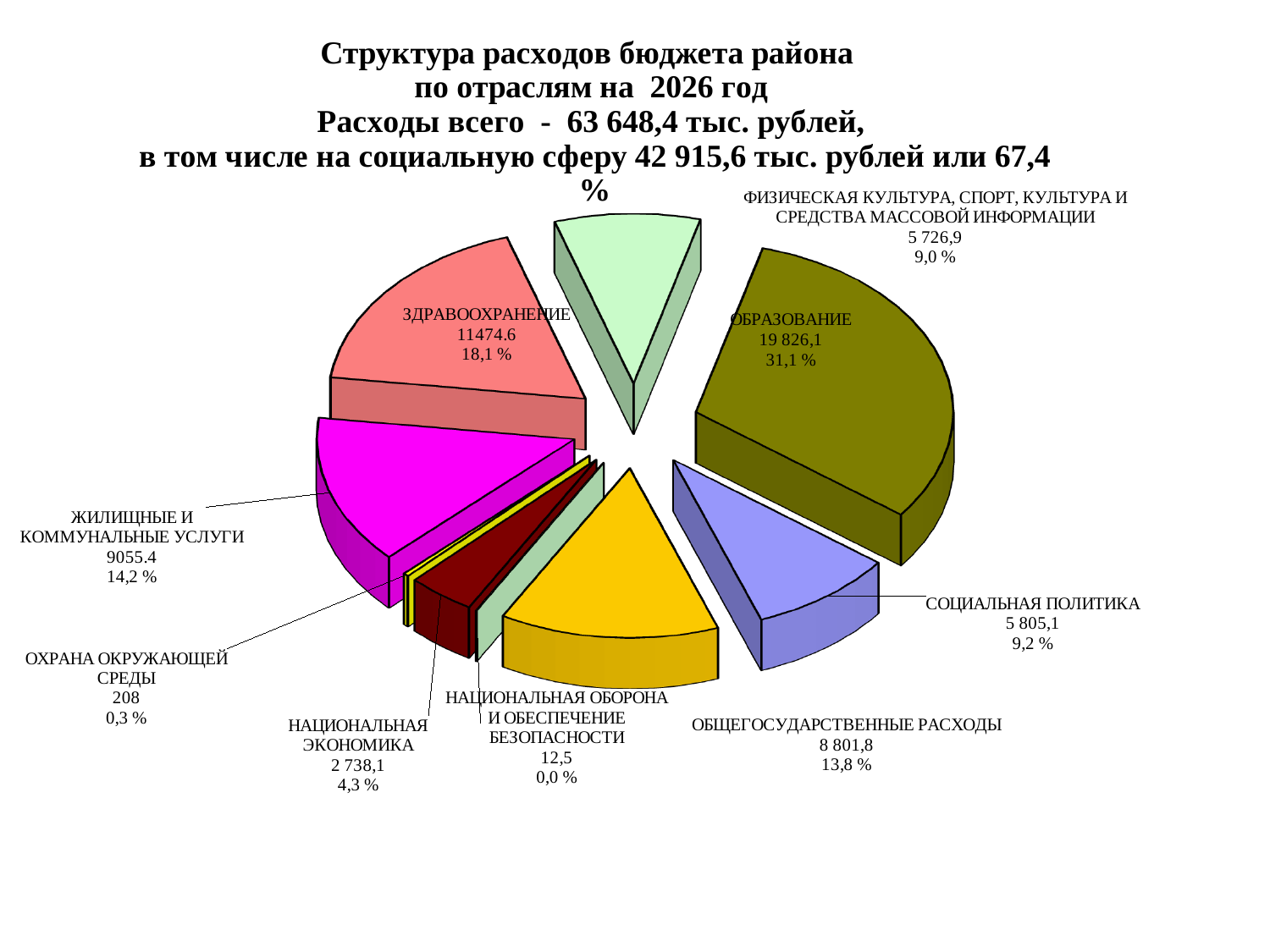
How many slices does the pie chart have? 9 Which category has the smallest slice of the pie? НАЦИОНАЛЬНАЯ ОБОРОНА И ОБЕСПЕЧЕНИЕ БЕЗОПАСНОСТИ What is the value for ОБЩЕГОСУДАРСТВЕННЫЕ РАСХОДЫ? 8 801,8 What kind of chart is shown on the slide? pie chart What is the value for ОБРАЗОВАНИЕ? 19 826,1 What share of the pie does ОБРАЗОВАНИЕ represent? 31,1 % What is the value for ЗДРАВООХРАНЕНИЕ? 11474.6 Which category has the largest slice of the pie? ОБРАЗОВАНИЕ Which is larger, the value for ЗДРАВООХРАНЕНИЕ or the value for ЖИЛИЩНЫЕ И КОММУНАЛЬНЫЕ УСЛУГИ? ЗДРАВООХРАНЕНИЕ What share of the pie does ЖИЛИЩНЫЕ И КОММУНАЛЬНЫЕ УСЛУГИ represent? 14,2 % What is the value for ОХРАНА ОКРУЖАЮЩЕЙ СРЕДЫ? 208 What is the difference between the value for ОБРАЗОВАНИЕ and the value for ЗДРАВООХРАНЕНИЕ? 8 351,5